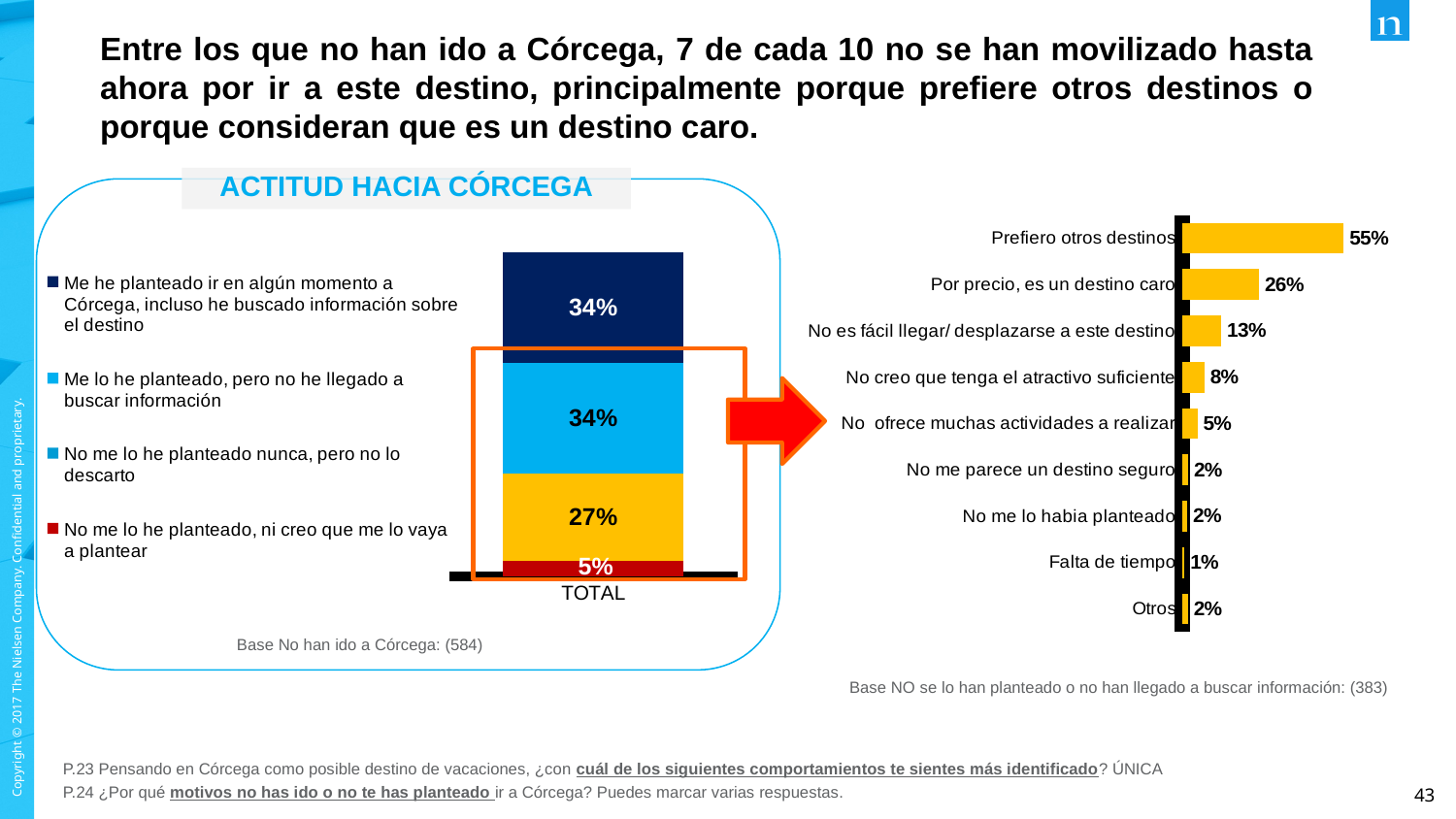
In the ACTITUD HACIA CÓRCEGA chart, what is the value for "No me lo he planteado nunca, pero no lo descarto"? 27% In the right-hand bar chart, what is the value for "Por precio, es un destino caro"? 26% In the right-hand bar chart, what is the value for "No es fácil llegar/ desplazarse a este destino"? 13% In the ACTITUD HACIA CÓRCEGA chart, what is the value for "No me lo he planteado, ni creo que me lo vaya a plantear"? 5% How many series does the legend of the ACTITUD HACIA CÓRCEGA chart list? 4 What kind of chart is the ACTITUD HACIA CÓRCEGA chart? Stacked bar chart In the right-hand bar chart, what is the difference between "Prefiero otros destinos" and "Por precio, es un destino caro"? 29% In the right-hand bar chart, what is the value for "Prefiero otros destinos"? 55% In the right-hand bar chart, which is larger: "No creo que tenga el atractivo suficiente" or "No ofrece muchas actividades a realizar"? No creo que tenga el atractivo suficiente In the right-hand bar chart, which category has the highest value? Prefiero otros destinos In the right-hand bar chart, which category has the lowest value? Falta de tiempo How many categories are shown in the right-hand bar chart? 9